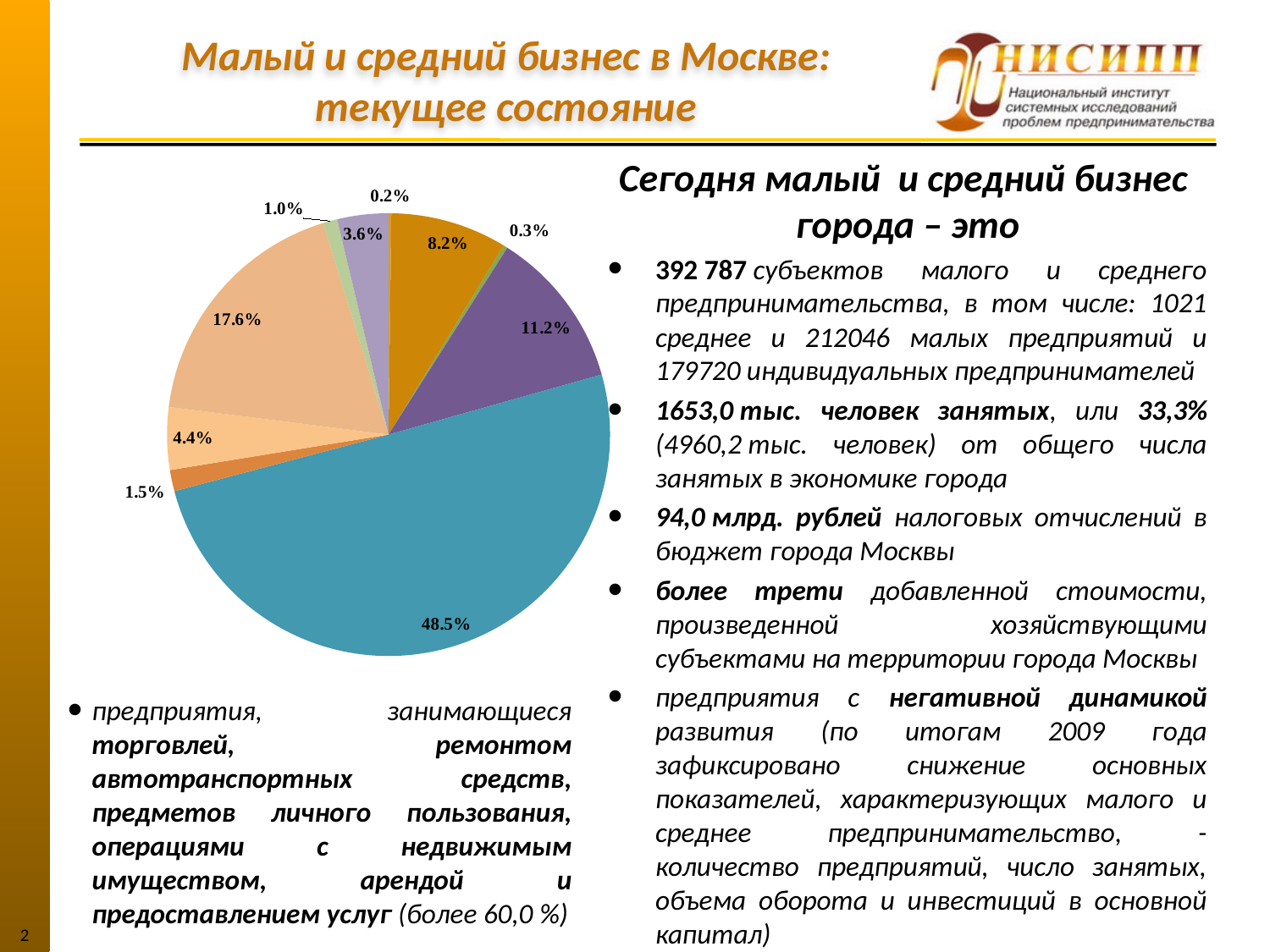
Which slice of the pie chart is larger: the one labelled 17.6% or the one labelled 11.2%? 17.6% What is the percentage labelled on the large light orange slice on the left of the pie chart? 17.6% What is the percentage labelled on the dark purple slice of the pie chart? 11.2% What is the largest percentage labelled on the pie chart? 48.5% What is the difference between the largest slice (48.5%) and the second largest slice (17.6%) of the pie chart? 30.9% How many slices of the pie chart have a percentage label? 10 What colour is the largest slice of the pie chart (48.5%)? teal Is the largest slice of the pie chart greater or less than 50%? less What is the smallest percentage labelled on the pie chart? 0.2% Does the pie chart include a legend naming its categories? No What kind of chart is shown on the left of the slide? pie chart What is the percentage labelled on the dark orange slice at the top of the pie chart? 8.2%